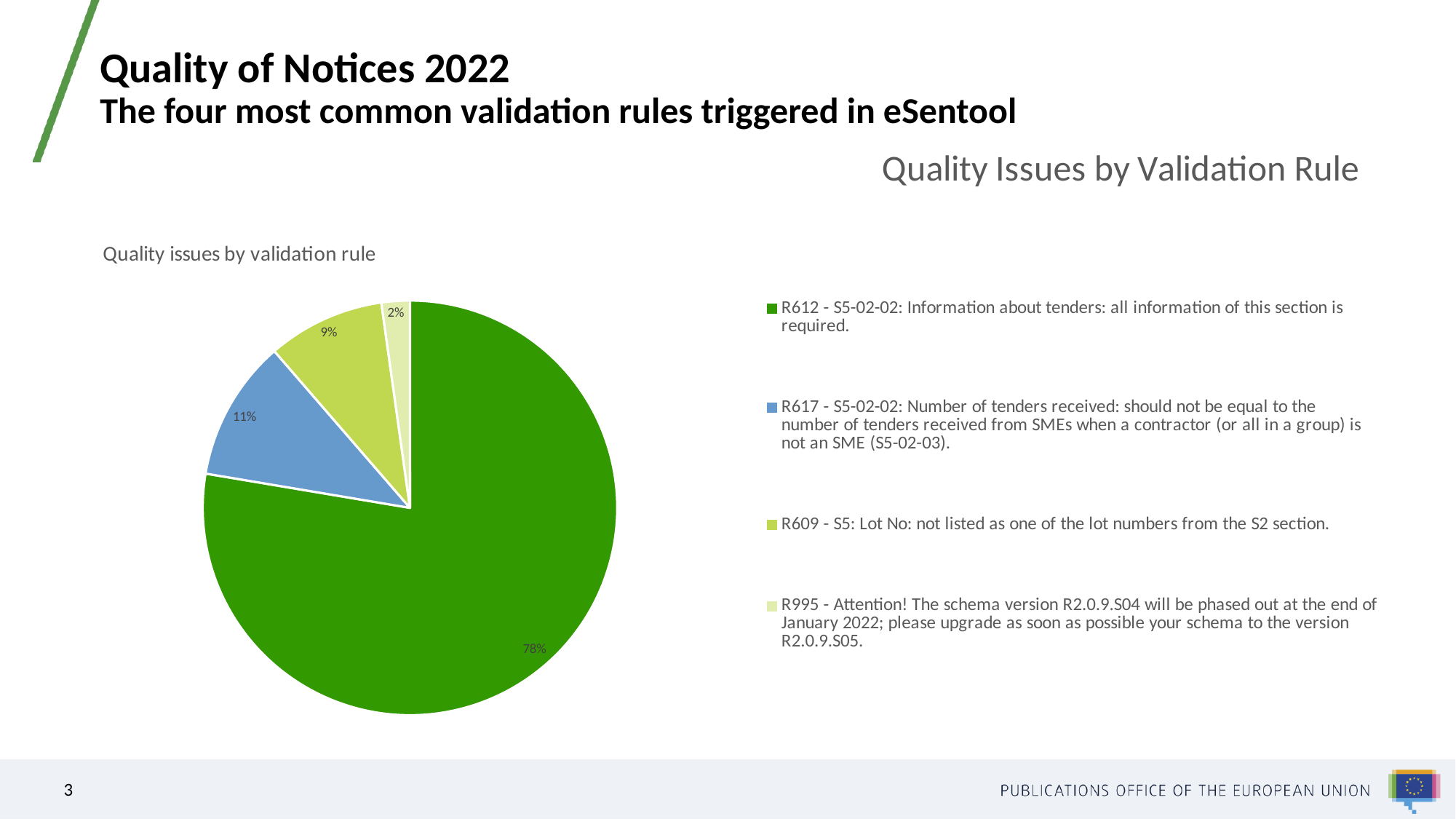
What colour is the slice for R617 in the pie chart? blue What share of the pie does R995 (schema version R2.0.9.S04 will be phased out) account for? 2% What share of the pie does R617 (Number of tenders received) account for? 11% What share of the pie does R609 (Lot No: not listed as one of the lot numbers from the S2 section) account for? 9% Which slice is larger, R617 or R609? R617 Which validation rule has the smallest slice of the pie? R995 Which validation rule has the largest slice of the pie? R612 How many slices does the pie chart have? 4 What is the difference in percentage points between the R612 slice and the R617 slice? 67 What is the title of the chart? Quality issues by validation rule What kind of chart is shown on the slide? pie chart